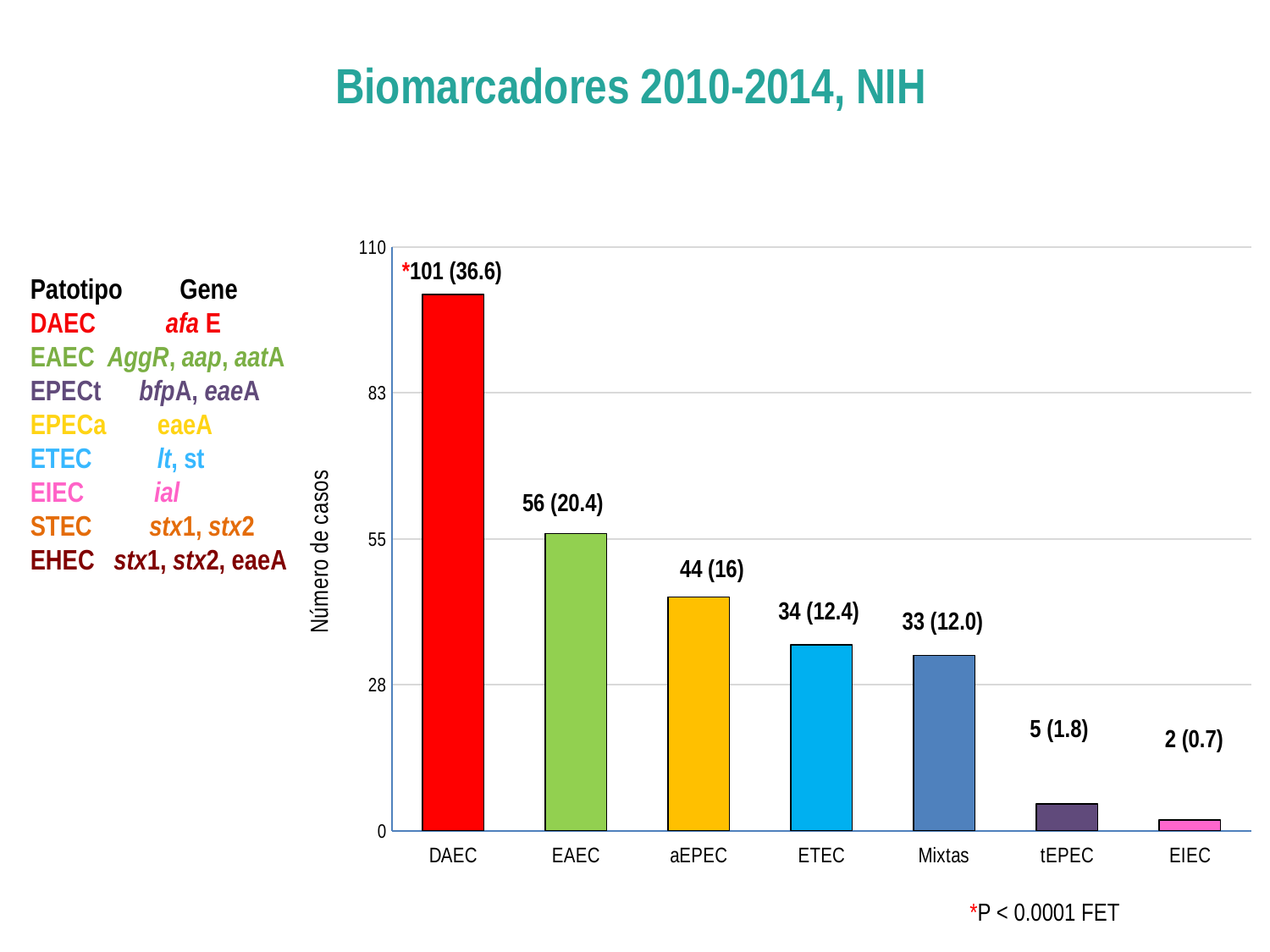
What is the data label shown for EIEC? 2 (0.7) What is the data label shown for EAEC? 56 (20.4) What is the difference in number of cases between aEPEC and tEPEC? 39 What is the number of cases for DAEC? 101 What is the number of cases for Mixtas? 33 Which has more cases, ETEC or tEPEC? ETEC What is the title of the chart's y axis? Número de casos Which category has the highest number of cases? DAEC How many categories are shown on the x axis? 7 Which category has the lowest number of cases? EIEC What is the difference in number of cases between DAEC and EAEC? 45 What kind of chart is shown on the slide? bar chart